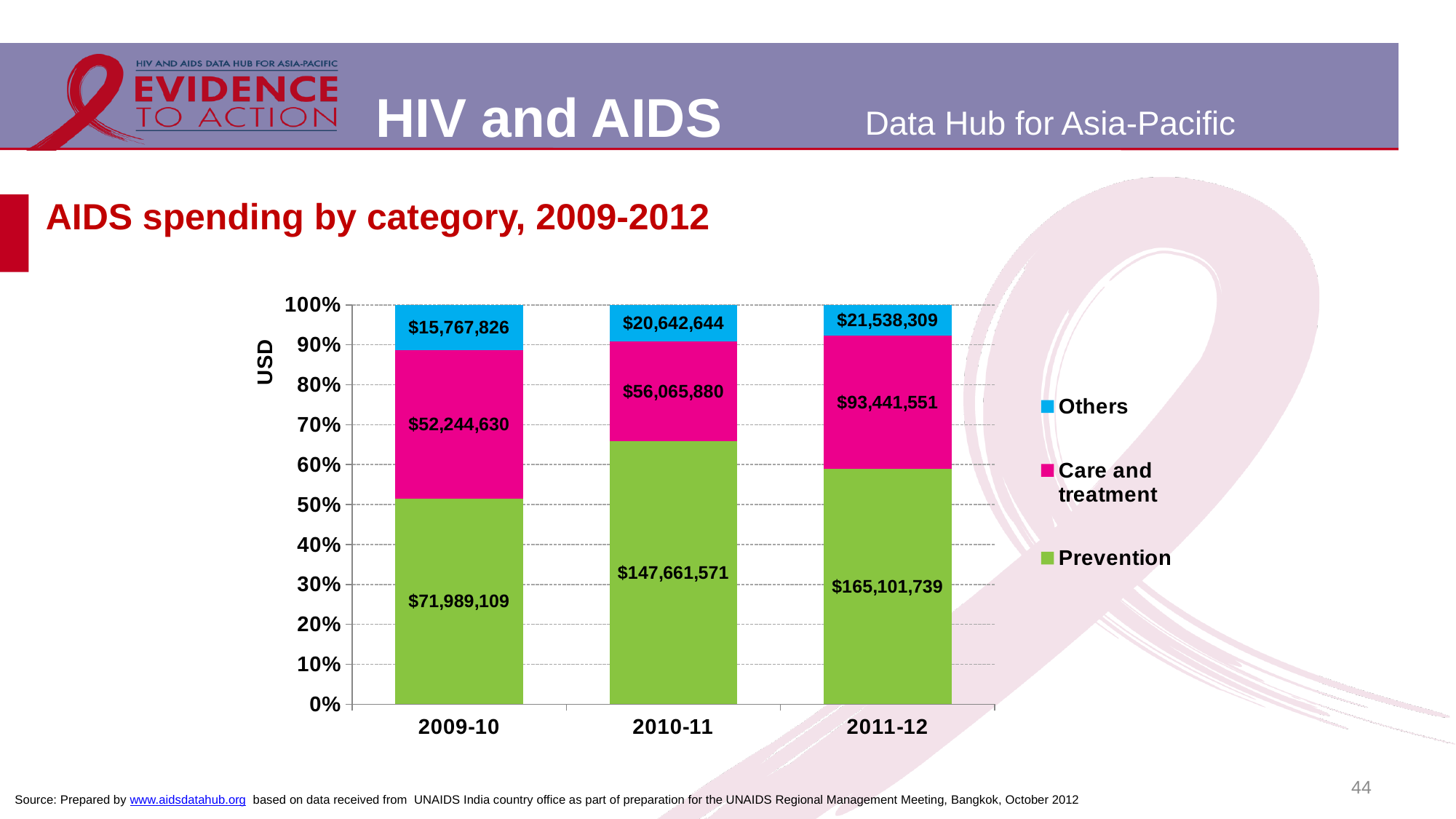
What is the Care and treatment spending value for 2011-12? $93,441,551 What is the total spending across all three categories for 2009-10? $140,001,565 How many years (bars) are shown on the x axis? 3 How many series does the legend list? 3 In which year is Others spending lowest? 2009-10 What kind of chart is shown on the slide? Stacked bar chart What is the difference between Prevention spending in 2011-12 and in 2009-10? $93,112,630 Which is larger: Care and treatment spending in 2010-11 or in 2011-12? 2011-12 Is the Prevention share of the 2010-11 bar greater or less than 60%? greater What is the Others spending value for 2010-11? $20,642,644 In which year is Prevention spending highest? 2011-12 What is the Prevention spending value for 2009-10? $71,989,109